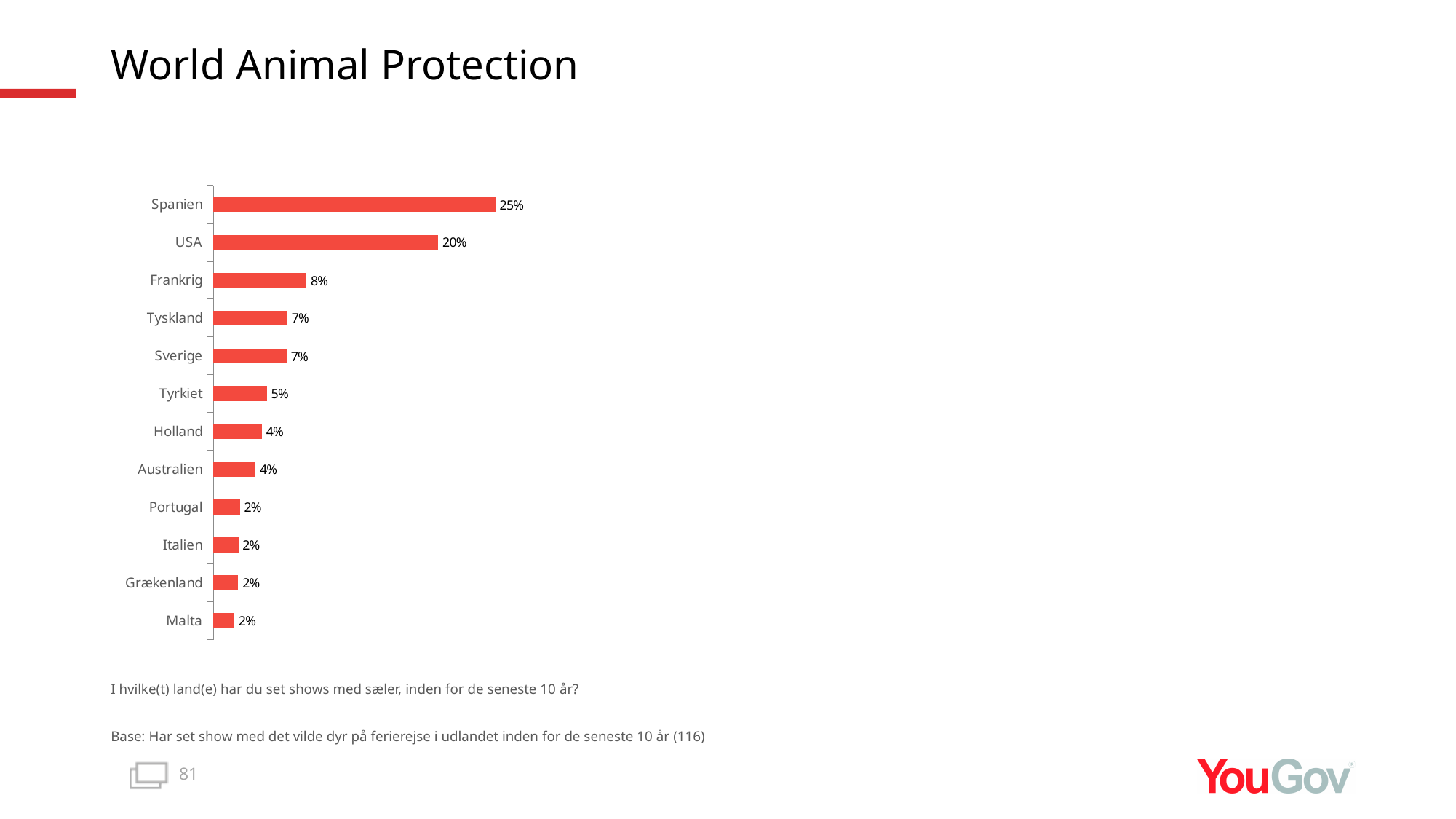
How many countries are shown in the chart? 12 What is the value for Spanien? 25% What kind of chart is shown on the slide? Bar chart What is the value for Tyrkiet? 5% What is the difference between the values for Frankrig and Tyskland? 1% Which country has the highest value? Spanien Which is larger, the value for USA or the value for Frankrig? USA What is the difference between the values for Spanien and USA? 5% What is the value for USA? 20% What is the value for Malta? 2% What colour are the bars in the chart? Red What is the value for Frankrig? 8%